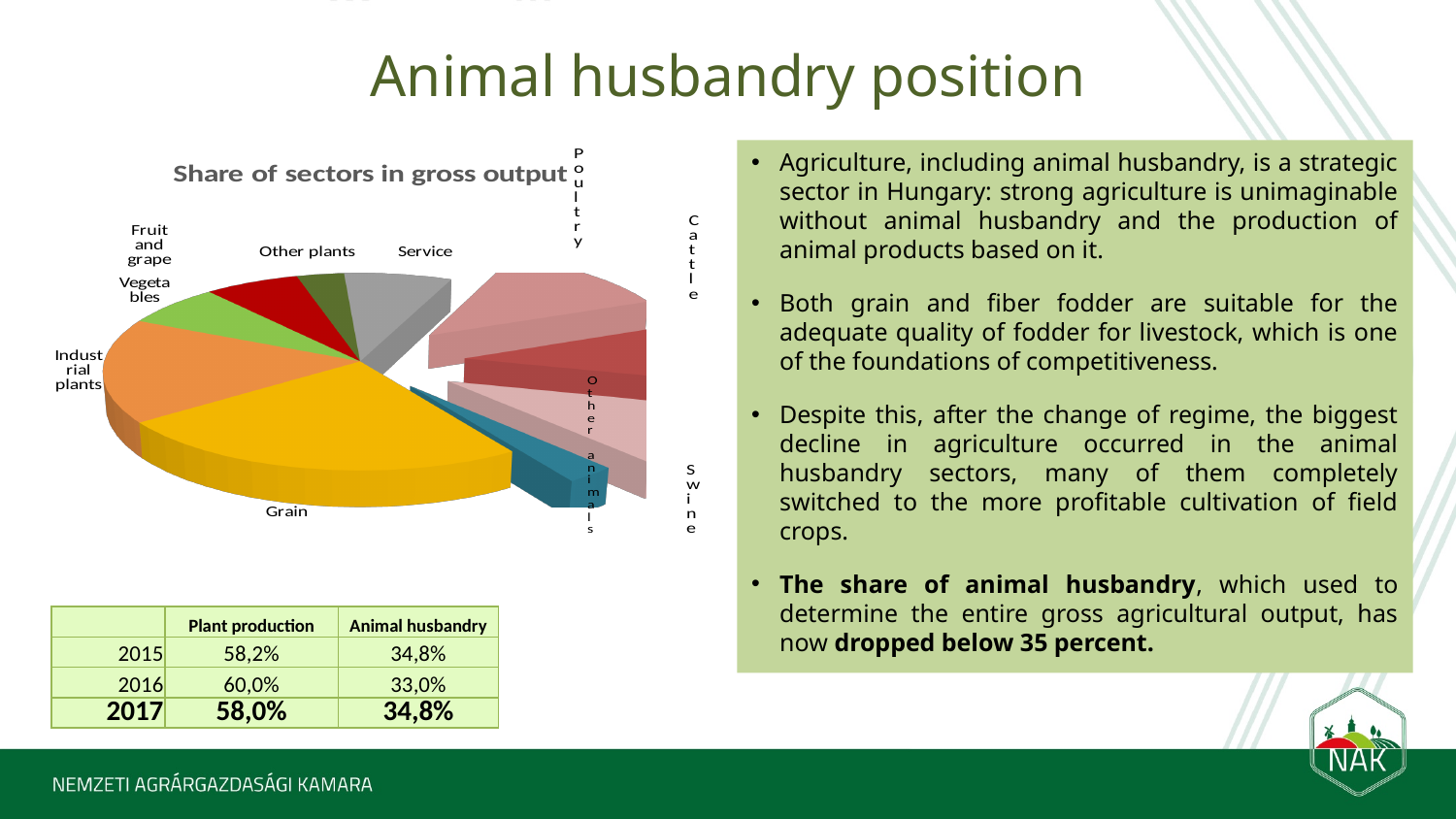
Which slice is larger, Industrial plants or Vegetables? Industrial plants What kind of chart is shown on the slide? Pie chart Which slice is larger, Grain or Service? Grain Which slice is larger, Industrial plants or Other plants? Industrial plants Which sector has the largest slice in the pie chart? Grain How many sectors (slices) are labelled in the pie chart? 10 What colour is the Grain slice in the pie chart? Yellow What is the title of the chart? Share of sectors in gross output